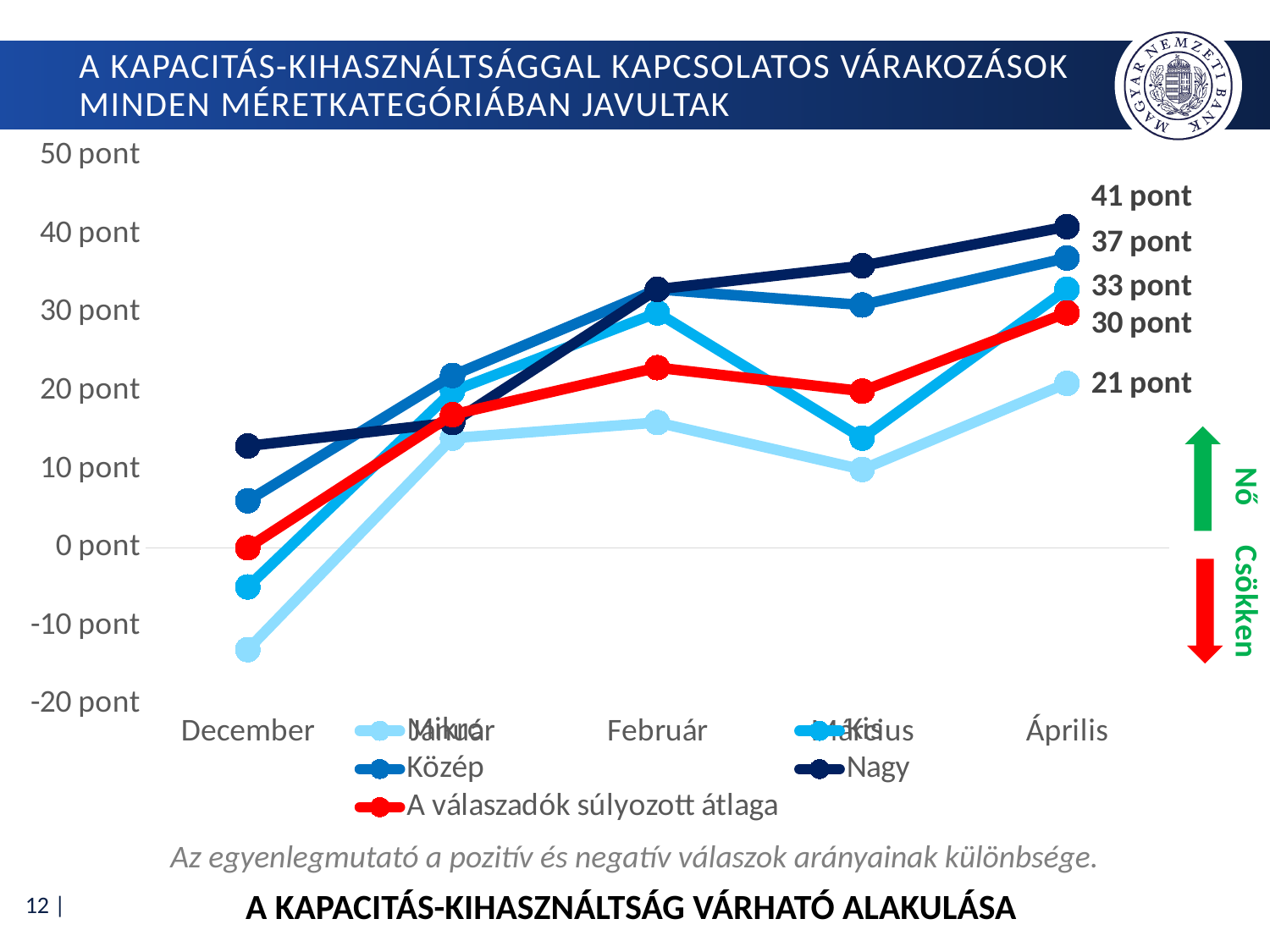
Which series has the highest value in Április? Nagy Which series has the lowest value in Április? Mikro What is the difference between the Nagy and Mikro values in Április? 20 pont How many months are shown along the x axis? 5 How many series does the legend list? 5 What is the value for Nagy in Április? 41 pont Is the value for Mikro in December greater or less than -10 pont? less What is the value for A válaszadók súlyozott átlaga in Április? 30 pont Does the Nagy series rise or fall from December to Április? rises What is the value for Mikro in Április? 21 pont In Április, which is larger: the value for Közép or the value for Kis? Közép What kind of chart is shown on the slide? line chart